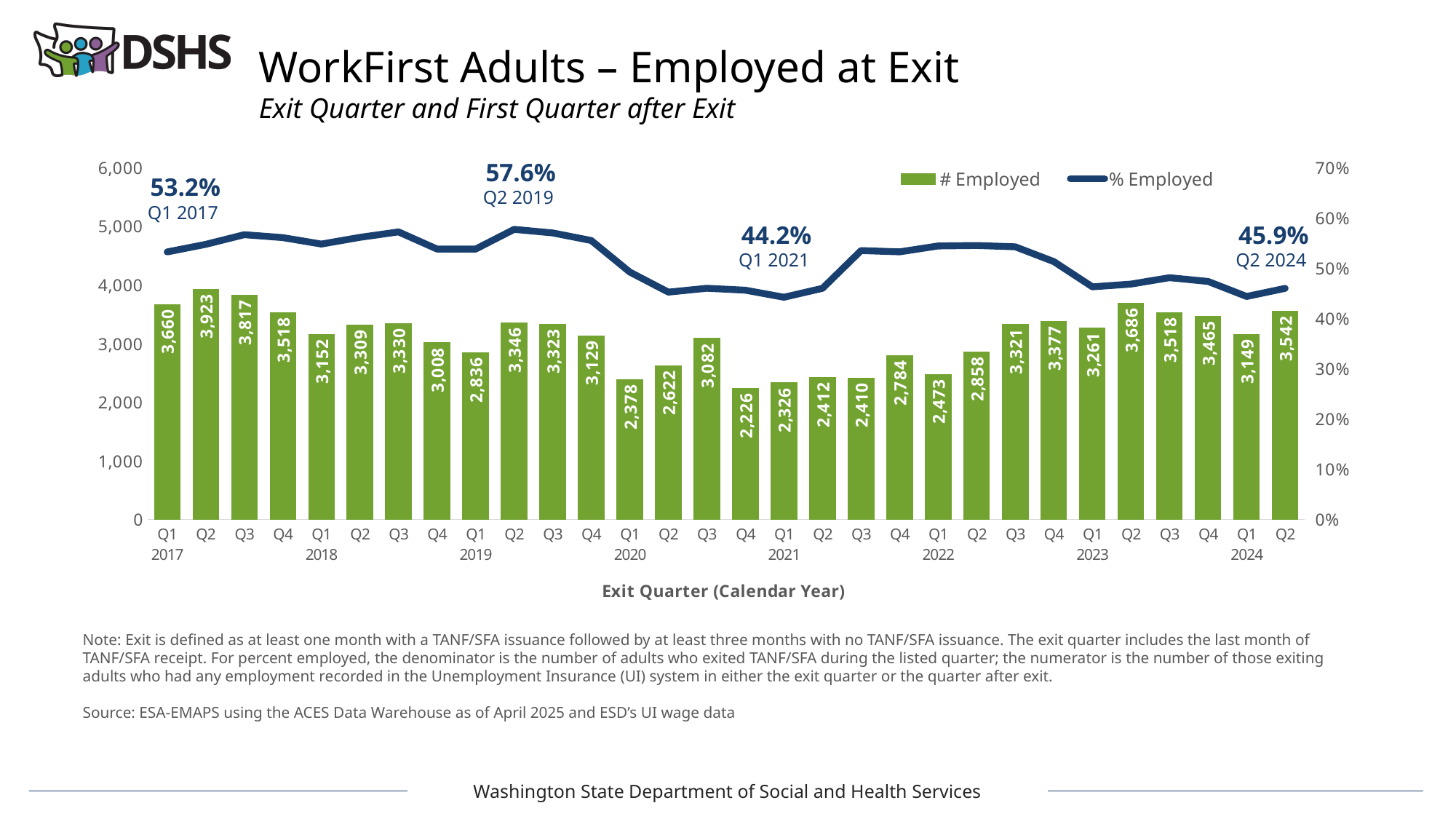
Which exit quarter has the highest # Employed? Q2 2017 What is the difference in # Employed between Q2 2024 and Q1 2024? 393 Which exit quarter has the lowest # Employed? Q4 2020 How many series does the legend list? 2 How many exit quarters are plotted on the chart? 30 What is the % Employed value labeled for Q2 2024? 45.9% What is the % Employed value labeled for Q2 2019? 57.6% Which is larger, the # Employed for Q3 2022 or for Q4 2022? Q4 2022 What is the # Employed value for Q4 2020? 2,226 Is the % Employed value for Q1 2021 greater or less than 50%? less What is the # Employed value for Q2 2017? 3,923 What is the difference between the labeled % Employed for Q2 2019 and Q1 2021? 13.4%